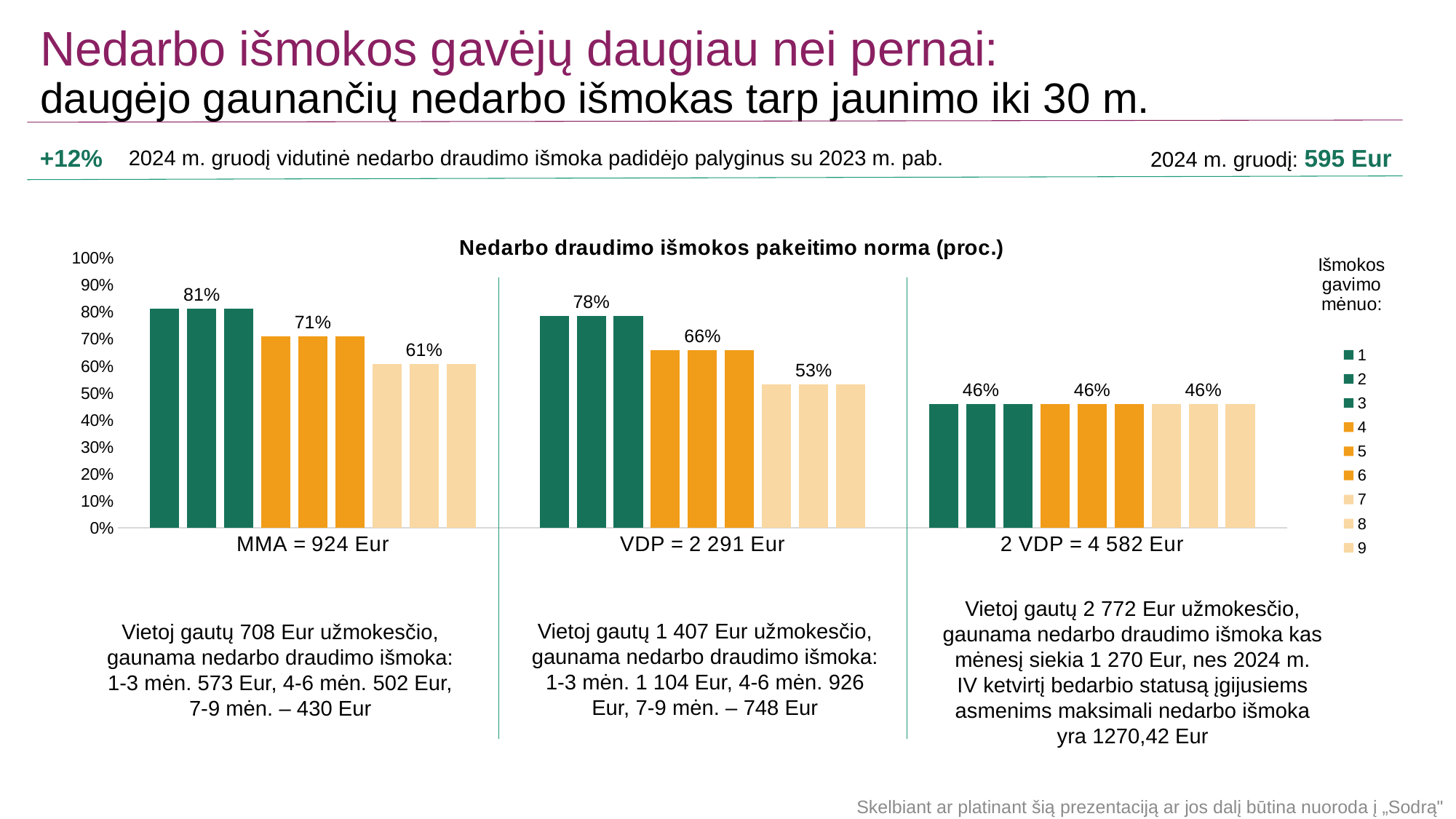
Which is larger: the months 7-9 rate for MMA = 924 Eur or the months 7-9 rate for VDP = 2 291 Eur? MMA = 924 Eur What is the title of the chart? Nedarbo draudimo išmokos pakeitimo norma (proc.) What is the replacement rate for months 4-6 in the VDP = 2 291 Eur category? 66% What is the difference between the month 1 replacement rate and the month 7 replacement rate in the MMA = 924 Eur category? 20% Which category has the highest replacement rate for month 1? MMA = 924 Eur How many series does the legend list? 9 What is the replacement rate for month 1 in the MMA = 924 Eur category? 81% Which category has the lowest replacement rate for months 7-9? 2 VDP = 4 582 Eur Within the VDP = 2 291 Eur category, do the replacement rates rise or fall from month 1 to month 9? fall What type of chart is shown on the slide? bar chart How many categories are shown on the x axis of the chart? 3 What is the replacement rate for months 7-9 in the 2 VDP = 4 582 Eur category? 46%